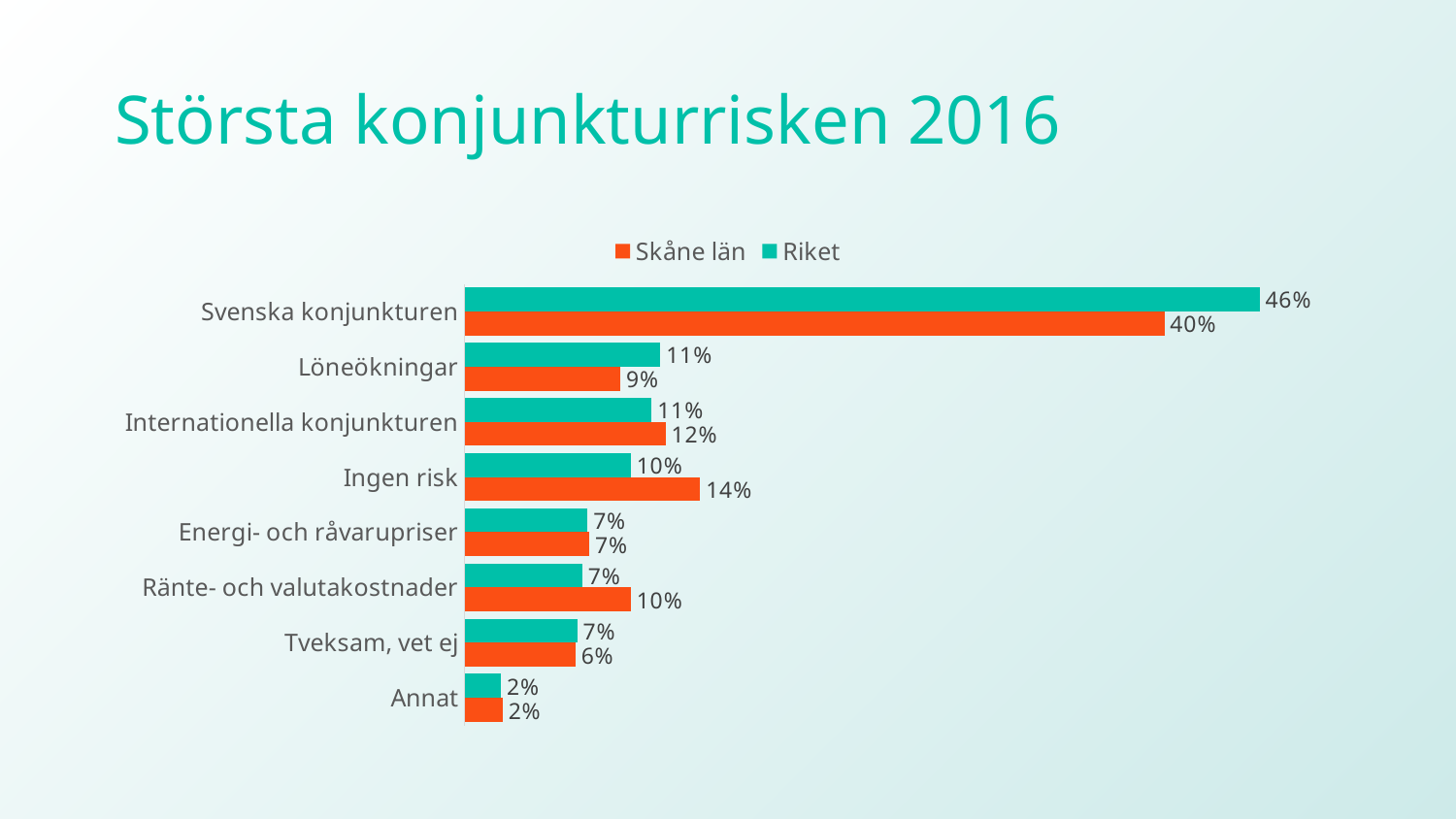
What is the difference between the Riket and Skåne län values for Svenska konjunkturen? 6% What kind of chart is shown on the slide? Bar chart Which category has the highest value for Skåne län? Svenska konjunkturen What is the value for Riket for Svenska konjunkturen? 46% How many categories are shown on the chart? 8 What is the difference between the Skåne län and Riket values for Ingen risk? 4% What is the title of the slide? Största konjunkturrisken 2016 What is the value for Skåne län for Ingen risk? 14% Which is larger for Löneökningar, the Skåne län value or the Riket value? Riket Which category has the lowest value for Riket? Annat How many series does the legend list? 2 What is the value for Skåne län for Ränte- och valutakostnader? 10%